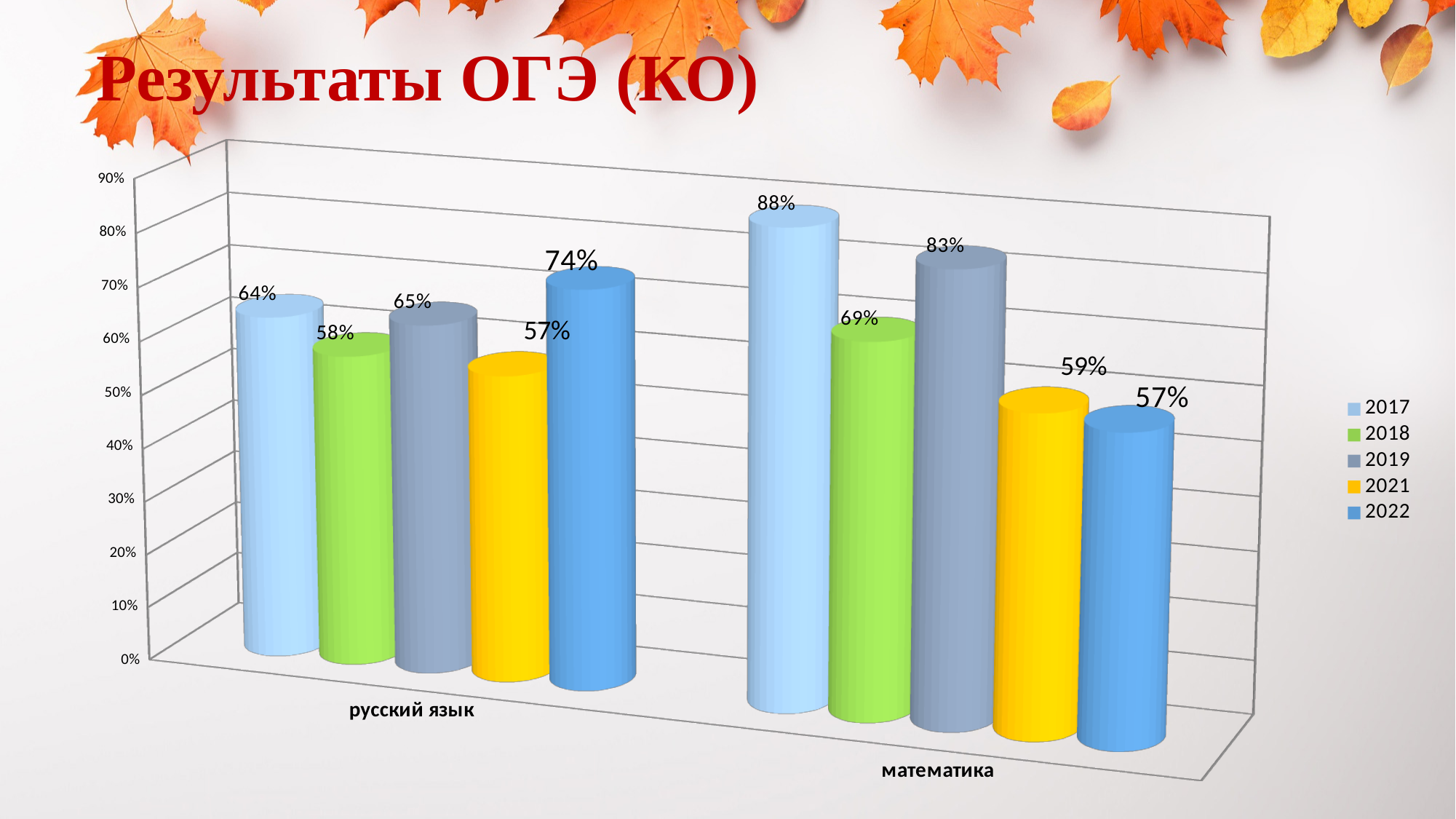
How many series does the legend list? 5 Which year has the highest value in the математика category? 2017 Which is larger: the 2017 value for русский язык or the 2017 value for математика? математика What is the difference between the 2019 and 2018 values in the математика category? 14% What kind of chart is shown on the slide? bar chart Is the value for 2018 in the русский язык category greater or less than 50%? greater Which year has the lowest value in the русский язык category? 2021 What is the value for 2022 in the русский язык category? 74% How many categories are shown on the x axis? 2 What is the value for 2021 in the математика category? 59% What is the title of the slide? Результаты ОГЭ (КО) What is the value for 2017 in the математика category? 88%